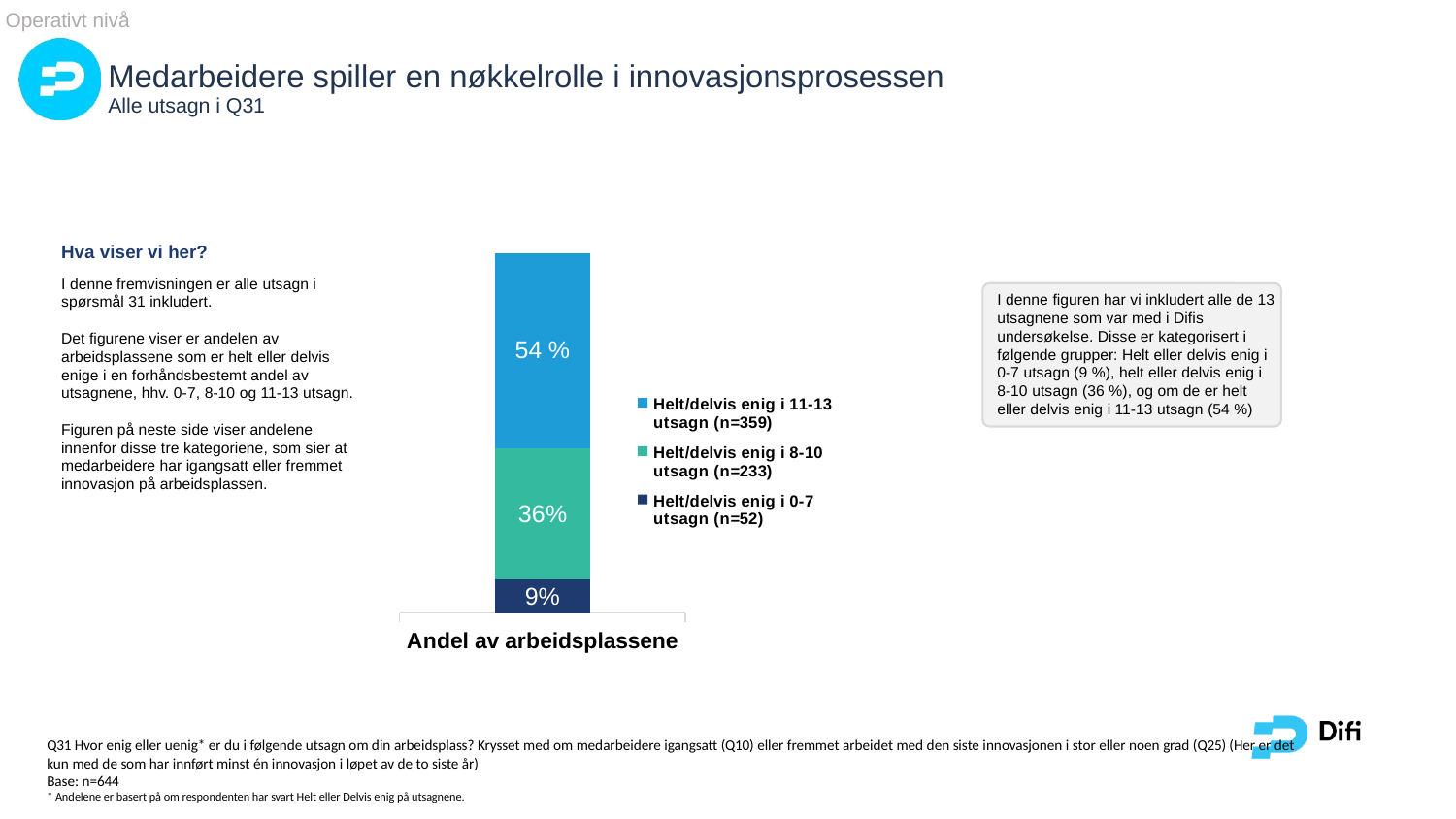
What is the difference between the values for "Helt/delvis enig i 11-13 utsagn" and "Helt/delvis enig i 8-10 utsagn"? 18 percentage points What is the value for the series "Helt/delvis enig i 0-7 utsagn (n=52)"? 9% How many categories are shown on the x axis? 1 Which is larger: the value for "Helt/delvis enig i 8-10 utsagn" or the value for "Helt/delvis enig i 0-7 utsagn"? Helt/delvis enig i 8-10 utsagn What is the label of the category on the x axis? Andel av arbeidsplassene What is the difference between the values for "Helt/delvis enig i 8-10 utsagn" and "Helt/delvis enig i 0-7 utsagn"? 27 percentage points What is the value for the series "Helt/delvis enig i 11-13 utsagn (n=359)"? 54 % What type of chart is shown on the slide? Stacked bar chart What is the value for the series "Helt/delvis enig i 8-10 utsagn (n=233)"? 36% How many series does the legend list? 3 Which series has the largest share of the stacked bar? Helt/delvis enig i 11-13 utsagn (n=359) Which series has the smallest share of the stacked bar? Helt/delvis enig i 0-7 utsagn (n=52)